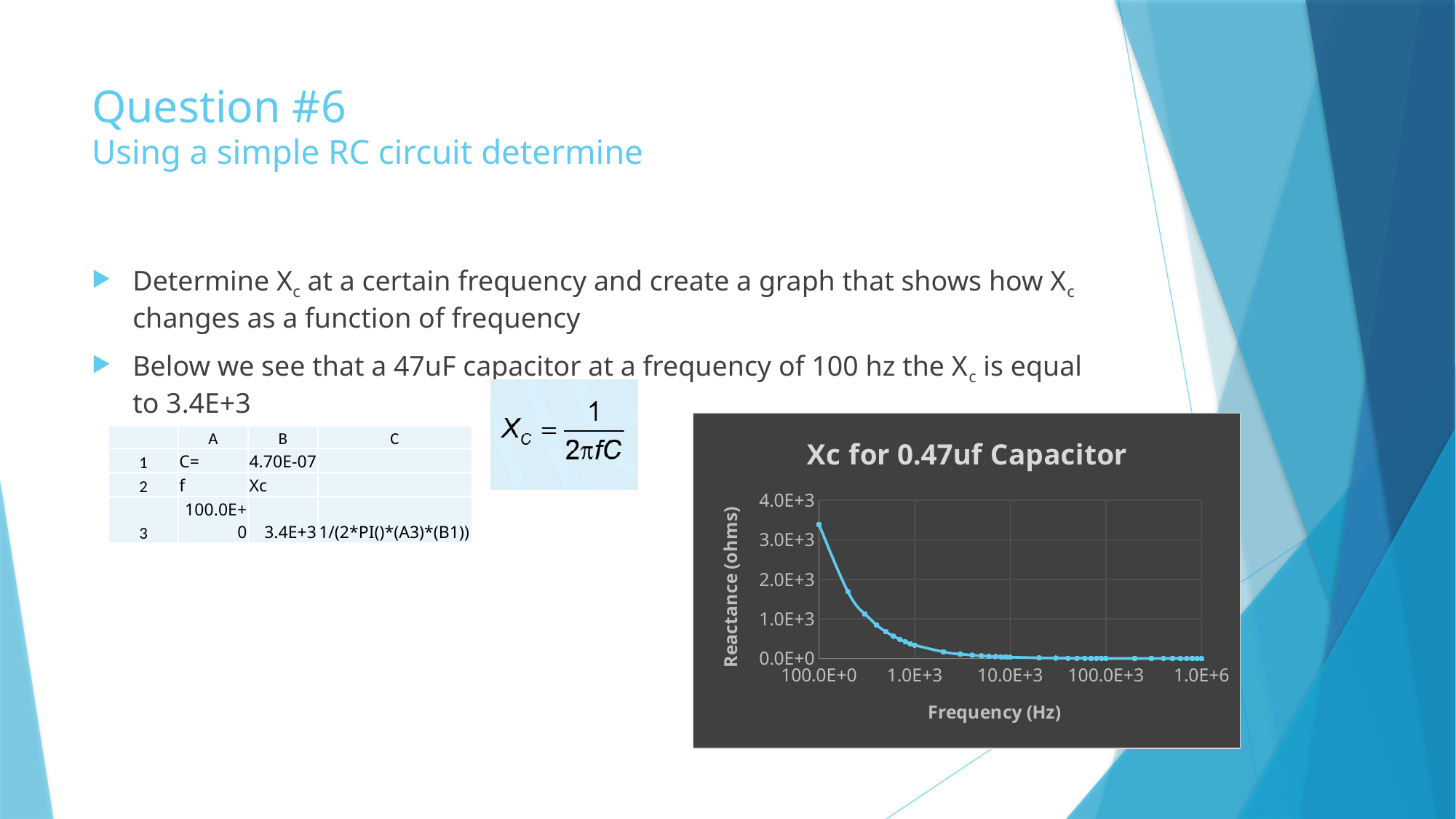
What type of chart is shown on the slide? line chart How many data series are plotted on the chart? 1 Does the reactance rise or fall as frequency increases along the x axis? fall At which frequency on the x axis is the reactance highest? 100.0E+0 What is the label of the vertical axis of the chart? Reactance (ohms) Which has the larger reactance: the point at 100.0E+0 Hz or the point at 1.0E+6 Hz? 100.0E+0 Hz Is the reactance at a frequency of 1.0E+3 Hz greater or less than 1.0E+3 ohms? less Is the reactance at a frequency of 100.0E+0 Hz greater or less than 3.0E+3 ohms? greater What is the title of the chart? Xc for 0.47uf Capacitor Is the reactance at a frequency of 10.0E+3 Hz greater or less than 1.0E+3 ohms? less